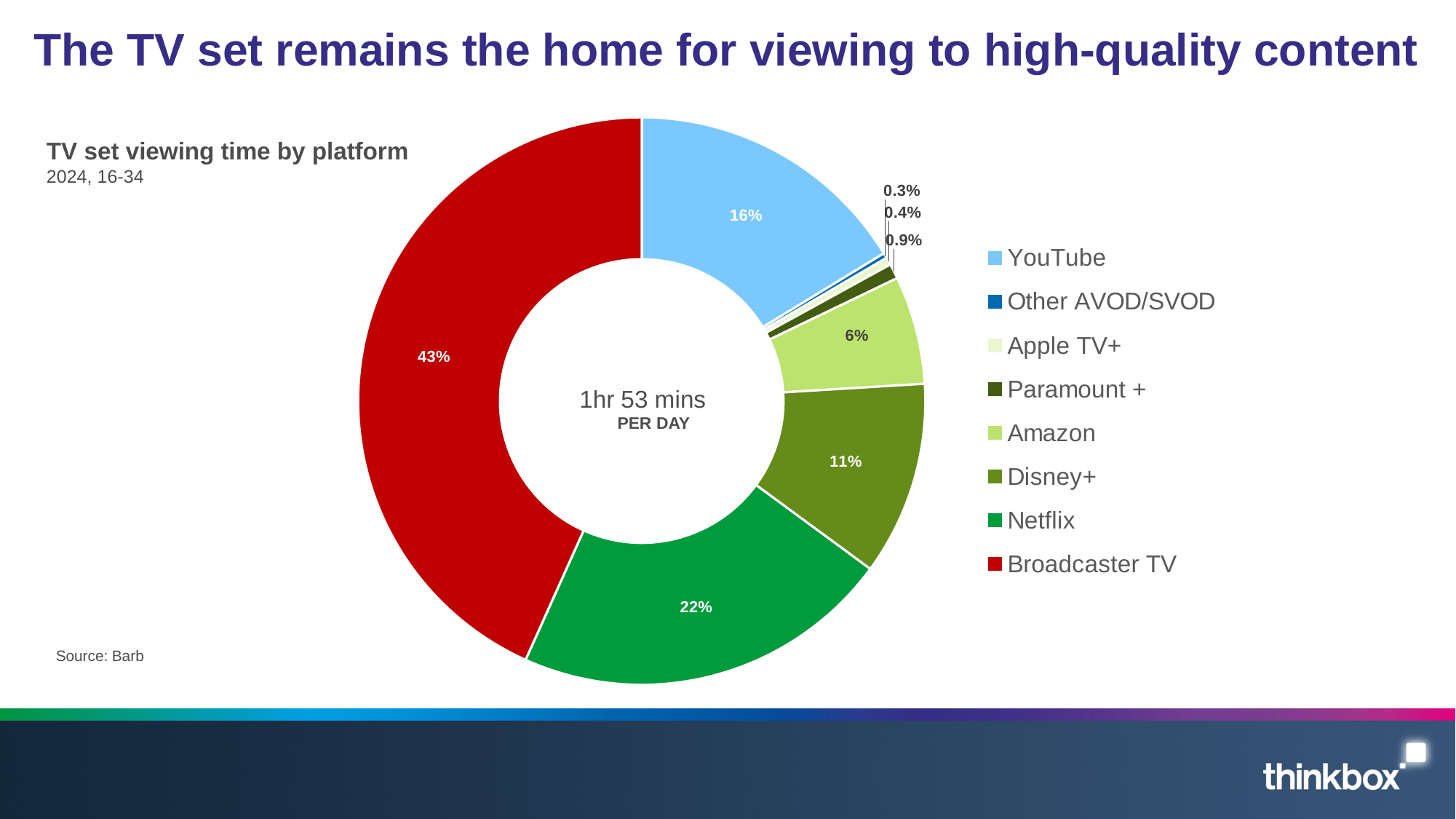
What is the value shown for Amazon? 6% Which platform has the largest share of TV set viewing time? Broadcaster TV What is the value shown for Netflix? 22% What kind of chart is shown on the slide? Pie chart (donut) What is the value shown for YouTube? 16% What total viewing time per day is shown in the centre of the chart? 1hr 53 mins Which has a larger share, YouTube or Disney+? YouTube What share of TV set viewing time does Broadcaster TV account for? 43% What is the difference in percentage points between Broadcaster TV and Netflix? 21 percentage points What is the value shown for Disney+? 11% What is the title of the chart? TV set viewing time by platform How many platforms are listed in the legend? 8